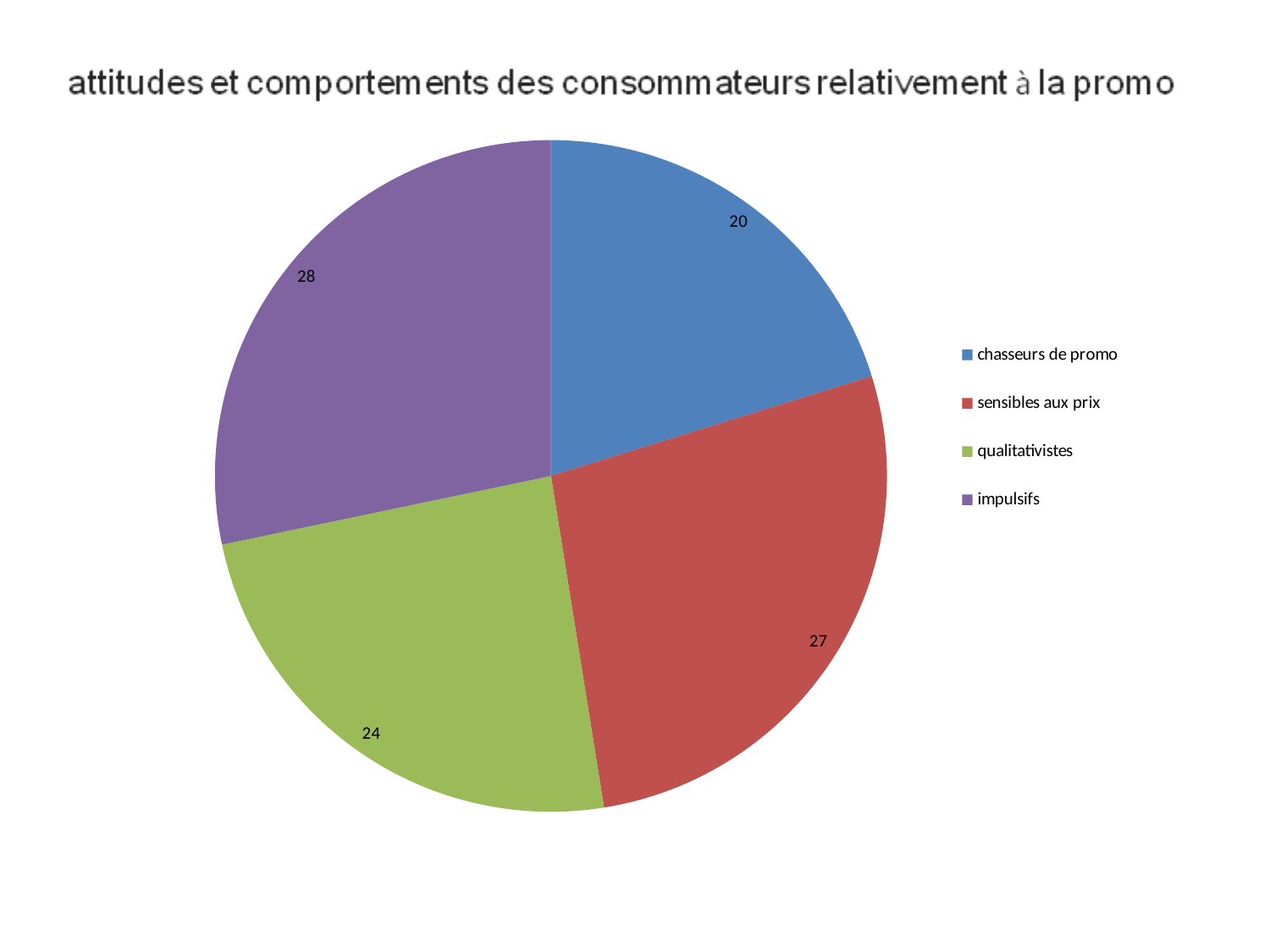
What is the value for chasseurs de promo? 20 How many categories does the pie chart have? 4 What is the difference between the values for impulsifs and chasseurs de promo? 8 What is the value for sensibles aux prix? 27 Which is larger, the value for sensibles aux prix or the value for qualitativistes? sensibles aux prix Which category has the smallest slice? chasseurs de promo What colour is the slice for qualitativistes? green Which category has the largest slice? impulsifs What is the value for qualitativistes? 24 What kind of chart is shown on the slide? pie chart What is the value for impulsifs? 28